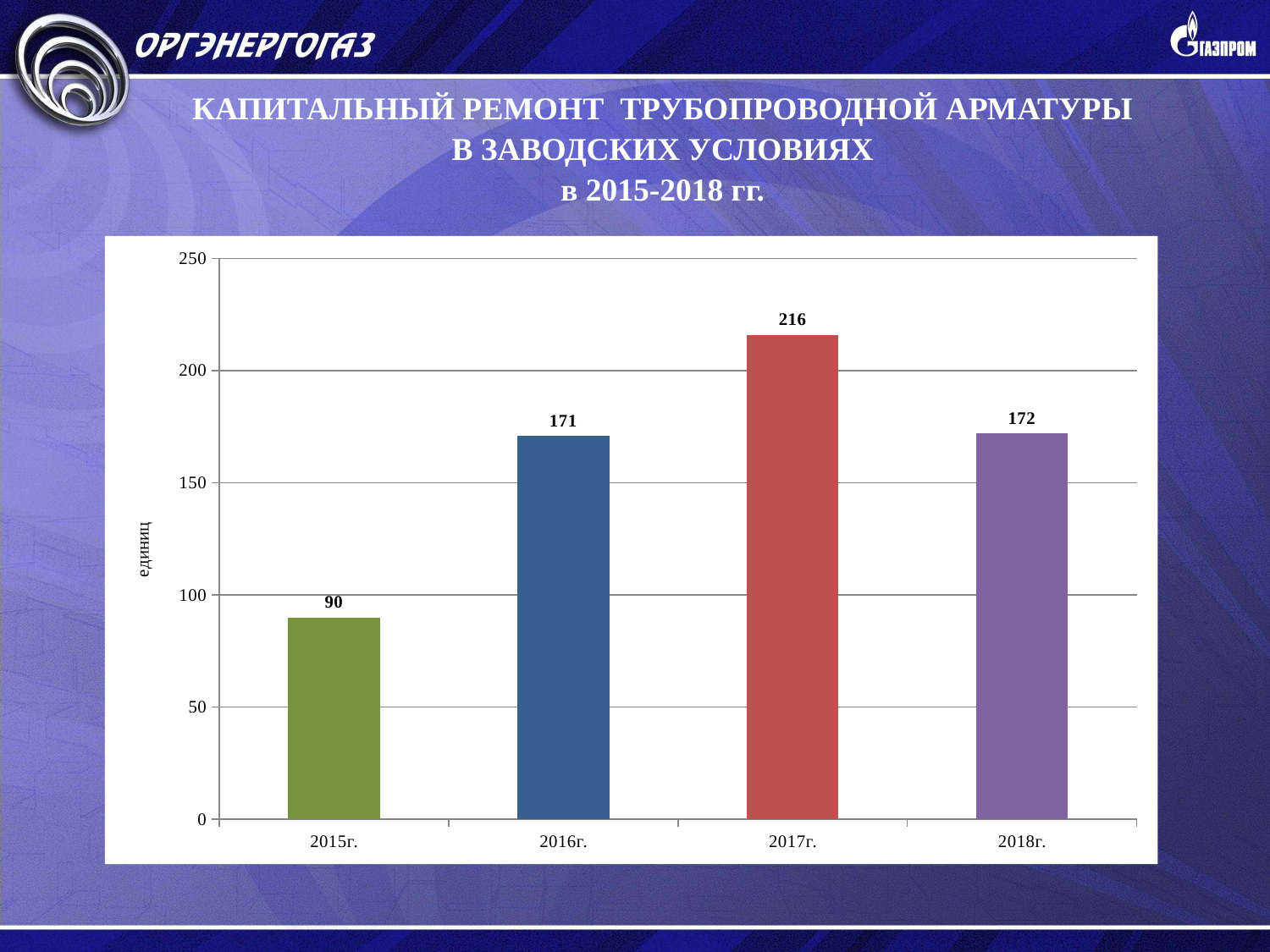
What kind of chart is shown on the slide? bar chart Is the value for 2015г. greater or less than 100? less What is the difference between the values for 2017г. and 2016г.? 45 What is the value for 2018г.? 172 Which is larger, the value for 2016г. or the value for 2017г.? 2017г. What is the value for 2015г.? 90 What is the value for 2017г.? 216 Which year has the highest value? 2017г. What is the difference between the values for 2016г. and 2015г.? 81 Which year has the lowest value? 2015г. What is the label on the vertical axis? единиц How many years are shown on the x axis? 4